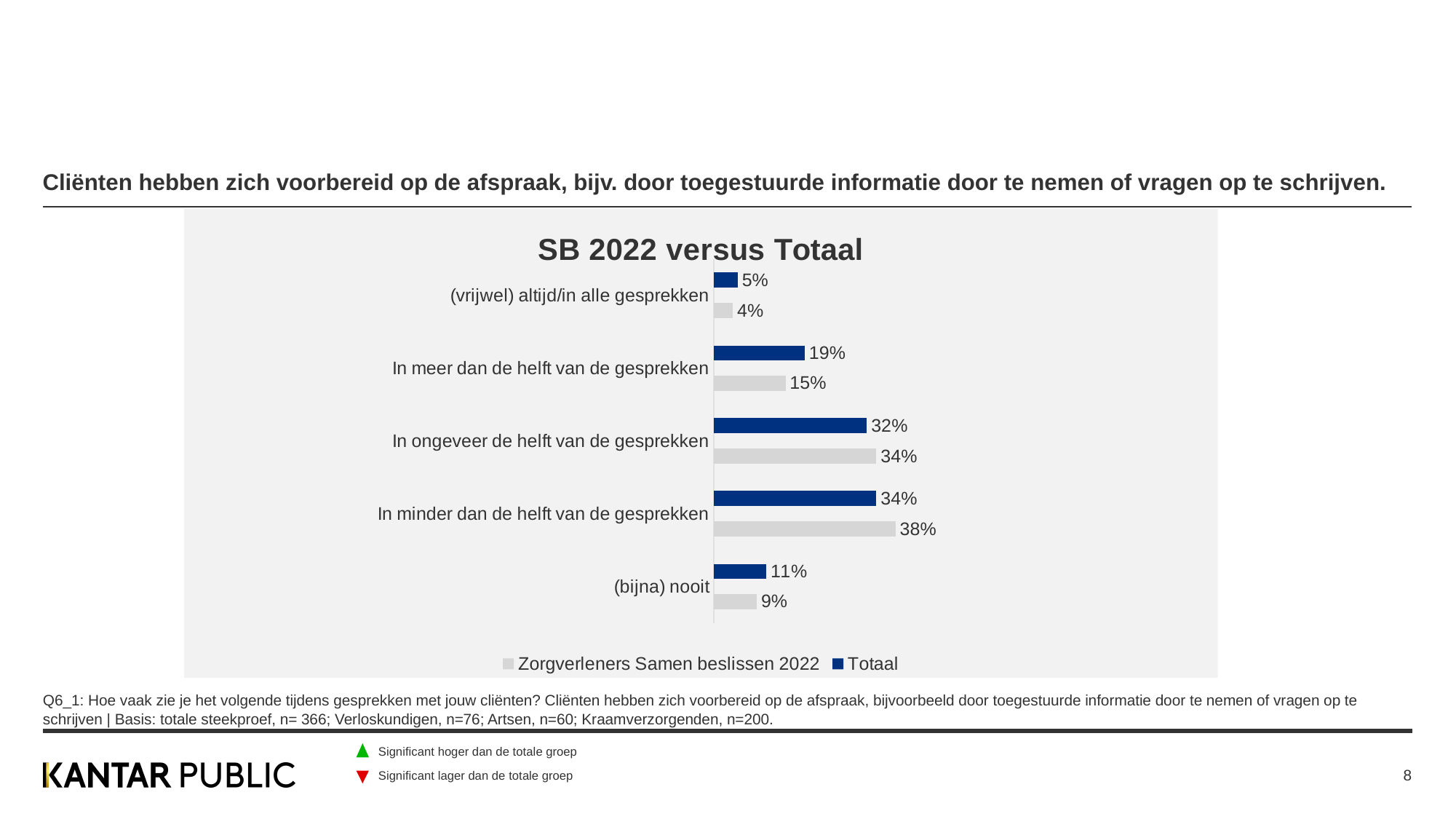
What kind of chart is shown on the slide? Bar chart How many categories are shown on the chart? 5 What is the title of the chart? SB 2022 versus Totaal Which category has the highest Totaal value? In minder dan de helft van de gesprekken What is the Totaal value for 'In ongeveer de helft van de gesprekken'? 32% Which category has the lowest Zorgverleners Samen beslissen 2022 value? (vrijwel) altijd/in alle gesprekken For 'In minder dan de helft van de gesprekken', which series has the larger value: Totaal or Zorgverleners Samen beslissen 2022? Zorgverleners Samen beslissen 2022 How many series does the legend list? 2 What is the Totaal value for '(bijna) nooit'? 11% What is the difference between the Totaal and Zorgverleners Samen beslissen 2022 values for 'In meer dan de helft van de gesprekken'? 4% What is the Zorgverleners Samen beslissen 2022 value for '(vrijwel) altijd/in alle gesprekken'? 4% What is the Zorgverleners Samen beslissen 2022 value for 'In minder dan de helft van de gesprekken'? 38%